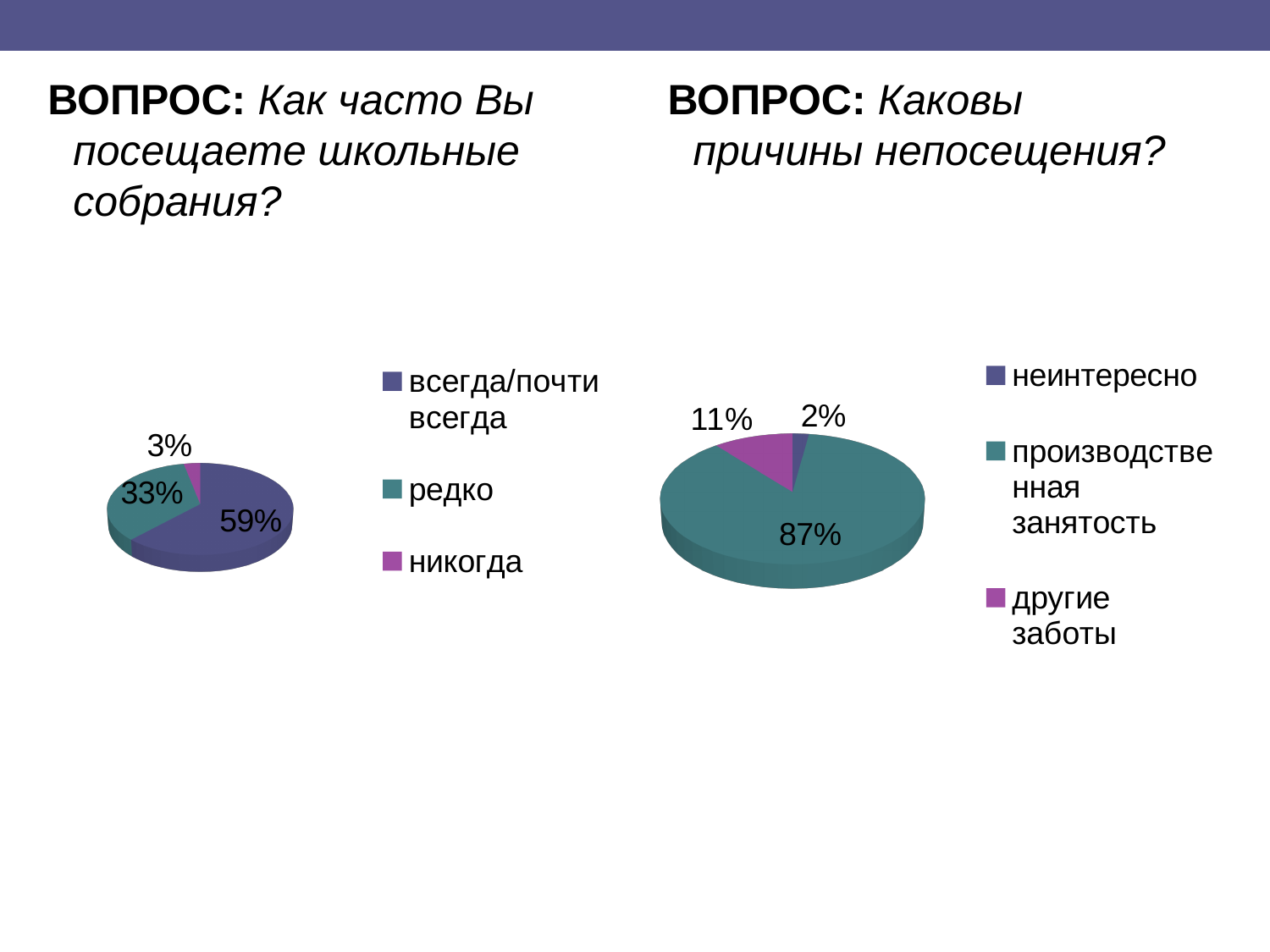
On the left pie chart, what share is labelled for 'никогда'? 3% On the left pie chart, which category has the largest slice? всегда/почти всегда On the left pie chart, what share is labelled for 'редко'? 33% How many categories does the legend of the right pie chart list? 3 On the left pie chart, what is the difference between the shares for 'всегда/почти всегда' and 'редко'? 26% On the right pie chart, what share is labelled for 'неинтересно'? 2% On the left pie chart, what share is labelled for 'всегда/почти всегда'? 59% On the left pie chart, which category has the smallest slice? никогда What type of chart is used on the left side of the slide? Pie chart On the right pie chart, which category has the smallest slice? неинтересно On the right pie chart, what share is labelled for 'производственная занятость'? 87% On the right pie chart, what share is labelled for 'другие заботы'? 11%